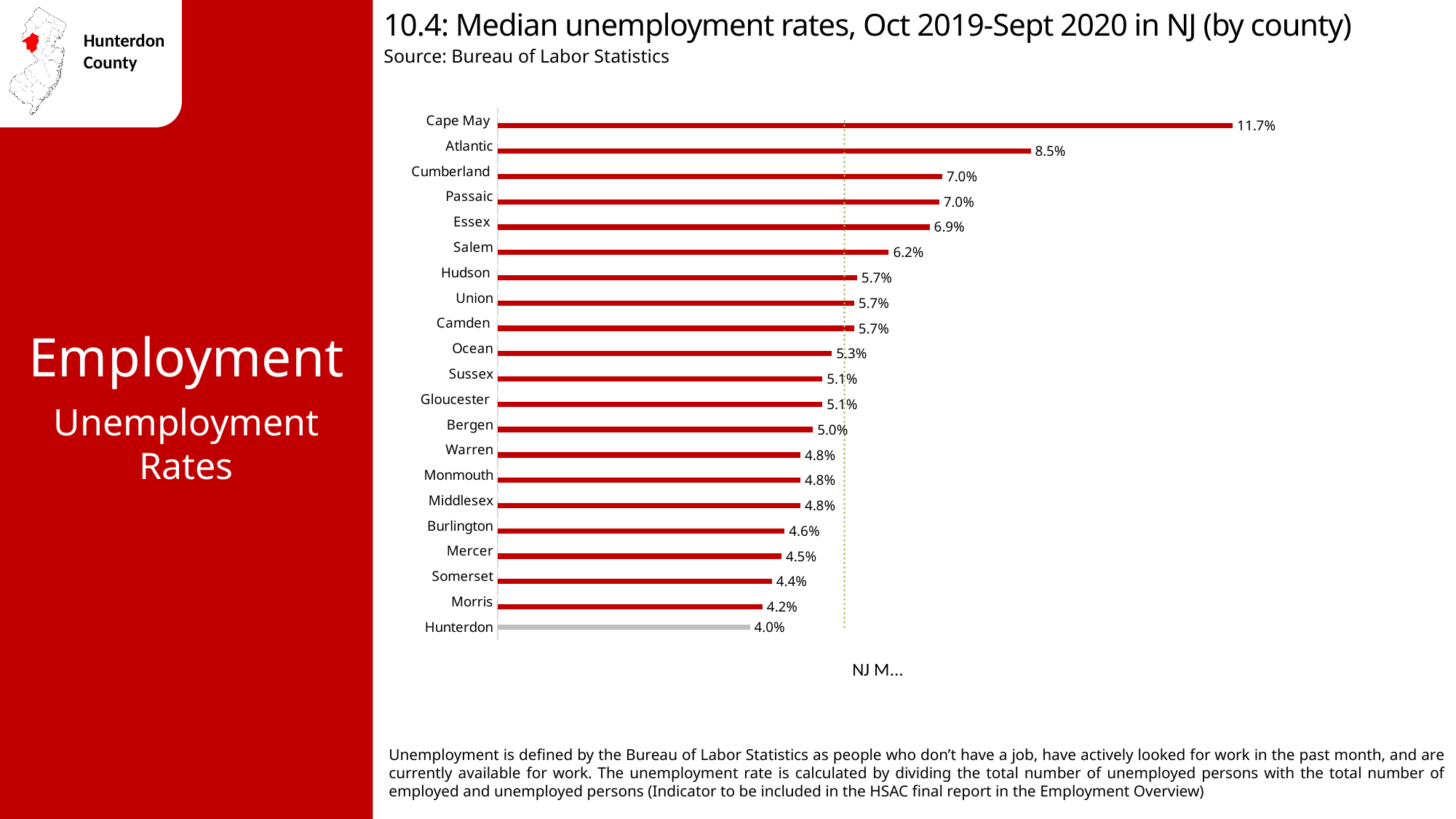
What is the difference between the median unemployment rates of Cape May and Atlantic? 3.2% What is the difference between the median unemployment rates of Morris and Hunterdon? 0.2% Which county has the lowest median unemployment rate? Hunterdon What kind of chart is shown on the slide? Bar chart How many counties are shown in the chart? 21 Which county's bar is shown in grey rather than red? Hunterdon What is the median unemployment rate for Hunterdon? 4.0% What is the source cited for the chart? Bureau of Labor Statistics What is the median unemployment rate for Cape May? 11.7% Which county has the highest median unemployment rate? Cape May What is the median unemployment rate for Salem? 6.2% Which county has a higher median unemployment rate, Essex or Ocean? Essex